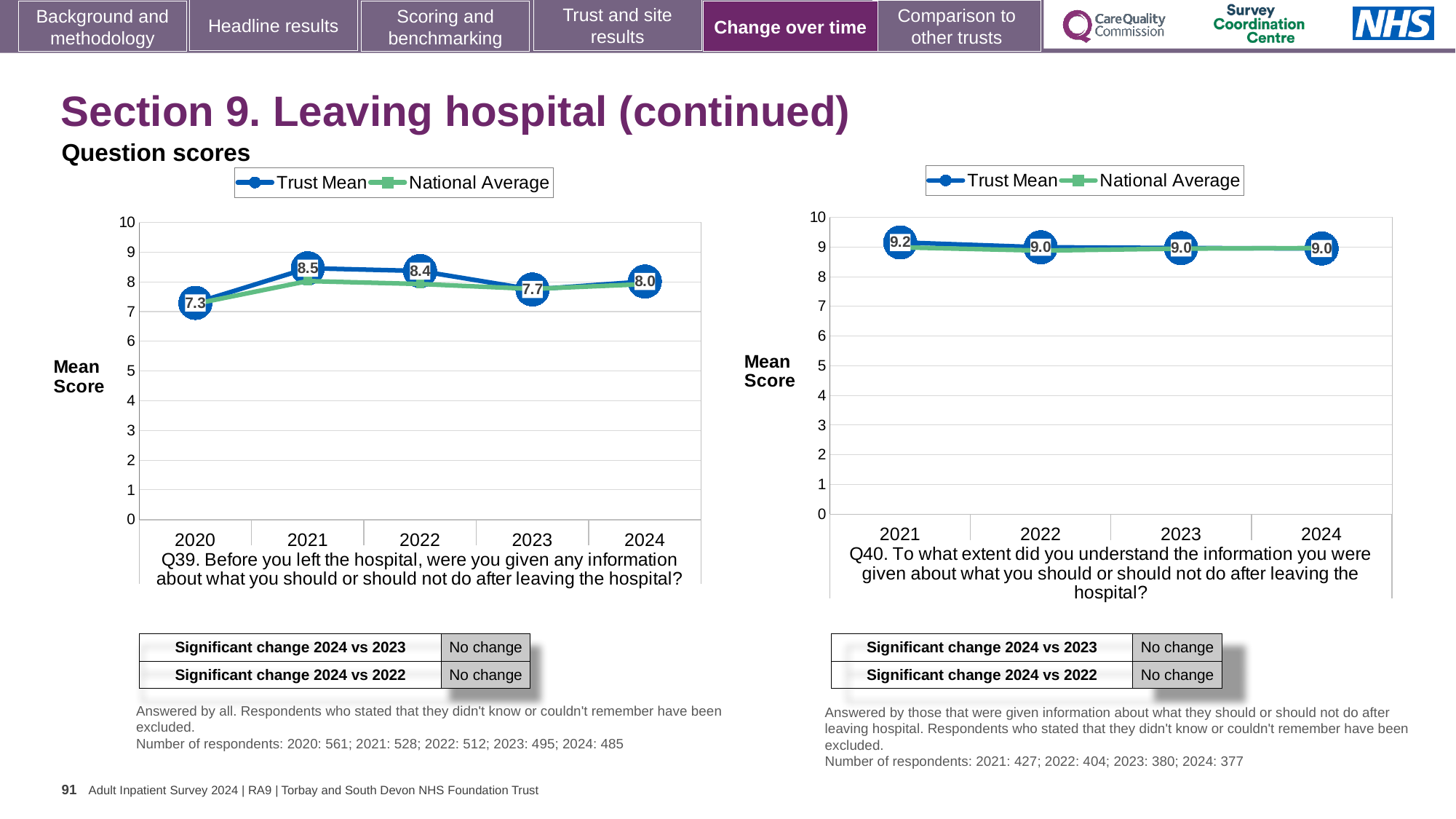
What kind of chart is the left chart (Q39)? Line chart On the left chart (Q39), is the Trust Mean higher in 2022 or in 2024? 2022 On the right chart (Q40), is the Trust Mean for 2022 greater or less than 8? greater On the left chart (Q39), what is the Trust Mean score for 2020? 7.3 On the left chart (Q39), in which year is the Trust Mean highest? 2021 How many series does the legend of the right chart (Q40) list? 2 On the left chart (Q39), what is the Trust Mean score for 2021? 8.5 On the right chart (Q40), what is the Trust Mean score for 2021? 9.2 On the left chart (Q39), how many years are shown on the x axis? 5 On the left chart (Q39), what is the difference between the Trust Mean in 2021 and in 2023? 0.8 On the left chart (Q39), in which year is the Trust Mean lowest? 2020 On the right chart (Q40), what is the Trust Mean score for 2024? 9.0